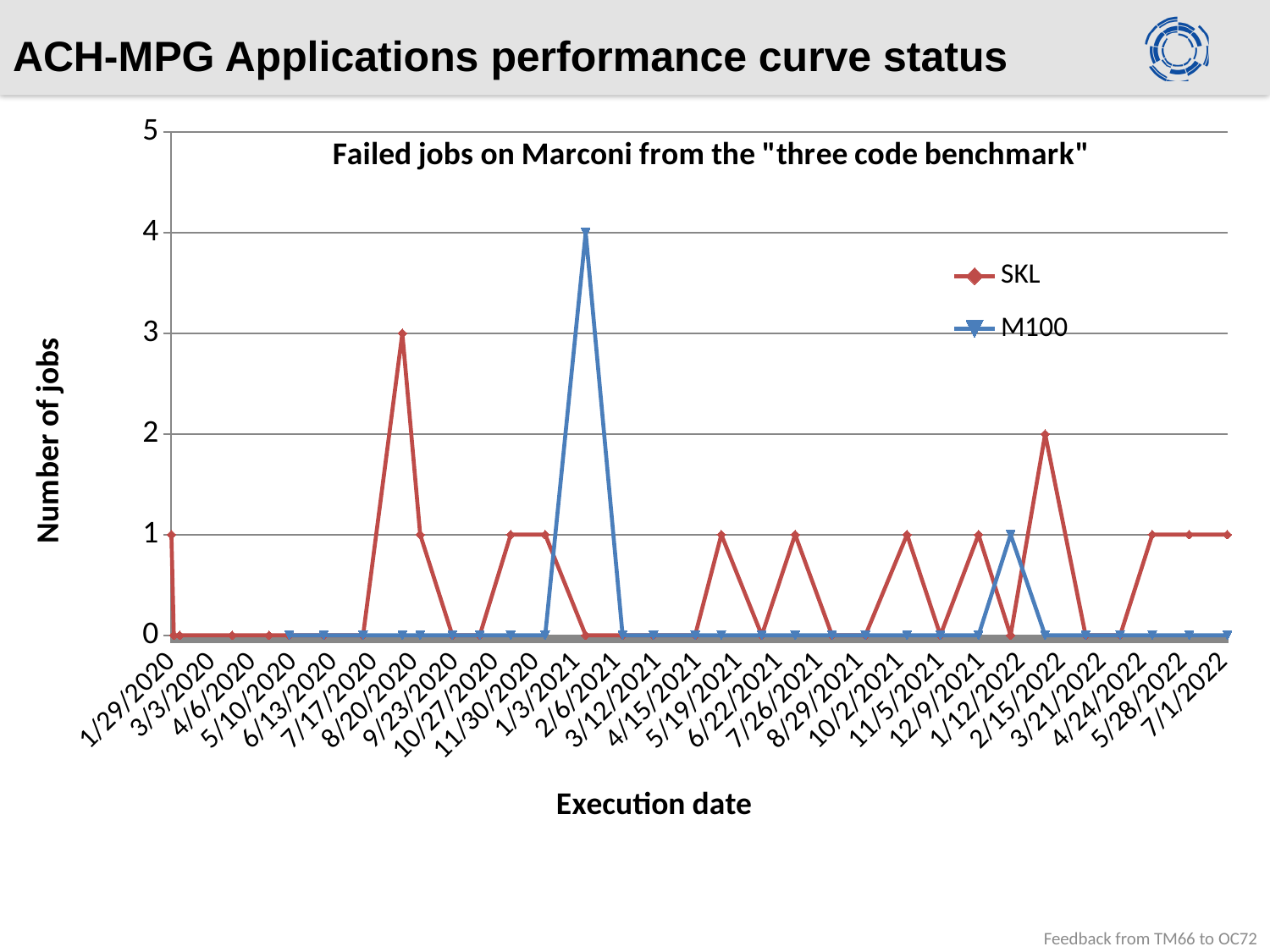
What is the label of the vertical axis? Number of jobs What is the highest value reached by the SKL series? 3 Which series reaches the higher peak value, SKL or M100? M100 What is the highest value reached by the M100 series? 4 How many series does the legend list? 2 What kind of chart is shown on the slide? line chart What is the title of the chart? Failed jobs on Marconi from the "three code benchmark" What is the difference between the peak value of M100 and the peak value of SKL? 1